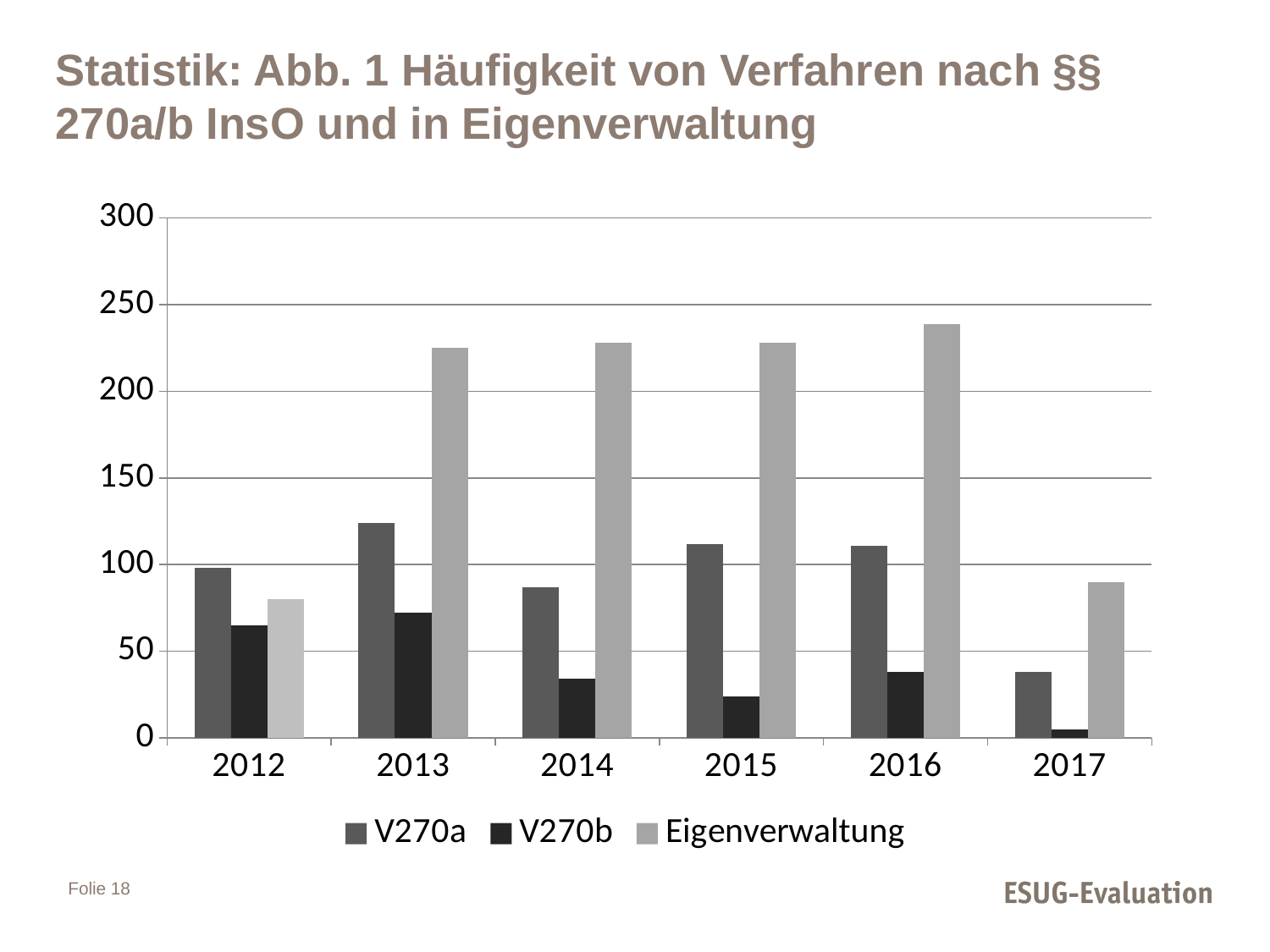
In which year is the V270b value lowest? 2017 In which year is the V270a value lowest? 2017 How many years are shown on the x axis? 6 In 2012, which is larger: V270a or Eigenverwaltung? V270a What kind of chart is shown on the slide? bar chart Is the Eigenverwaltung value for 2017 greater or less than 100? less Which series is shown in the lightest grey in the legend? Eigenverwaltung Is the Eigenverwaltung value for 2013 greater or less than 200? greater How many series does the legend list? 3 Is the V270b value for 2015 greater or less than 50? less In which year is the Eigenverwaltung value highest? 2016 In which year is the V270a value highest? 2013